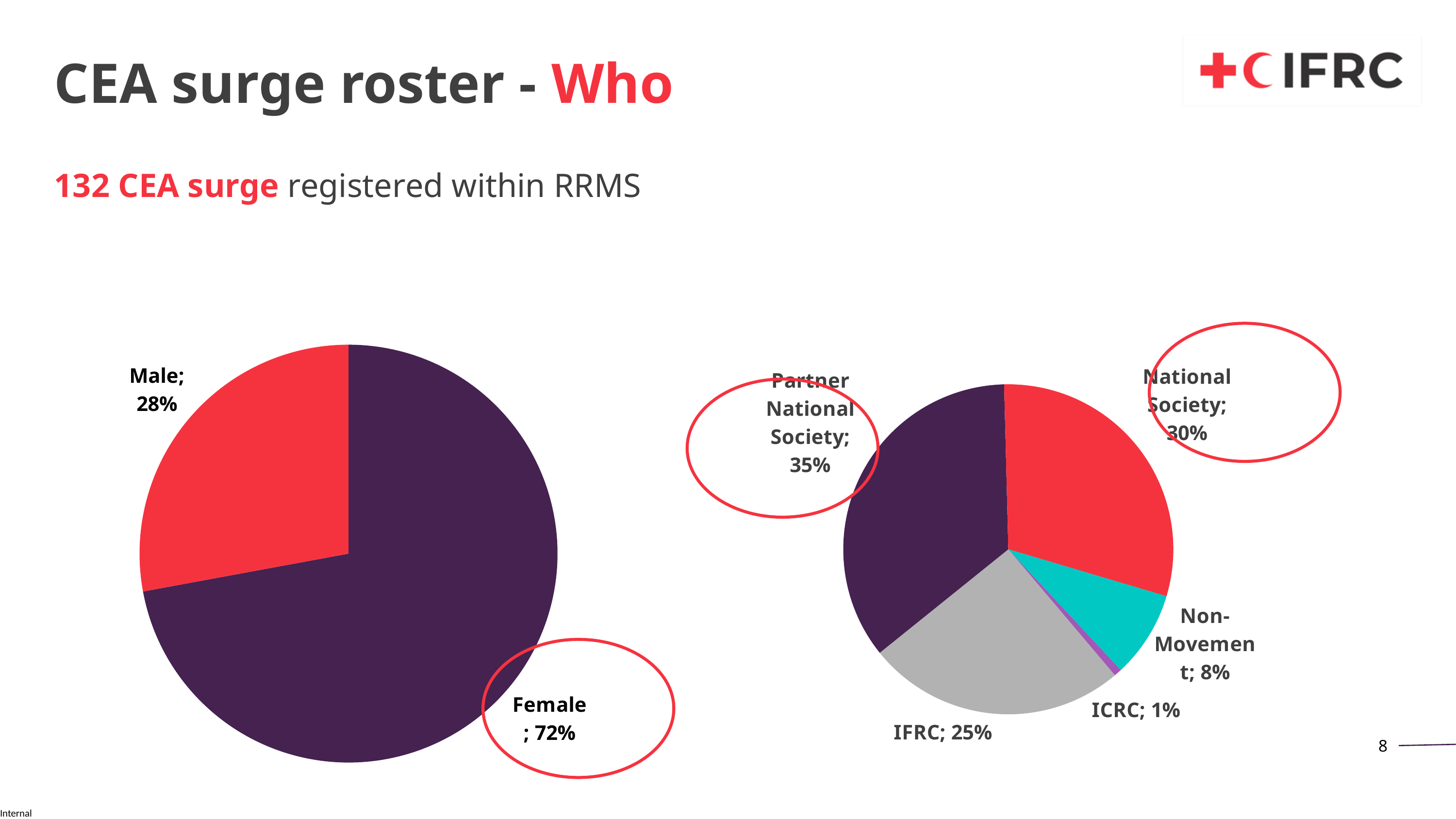
In the right pie chart, what is the difference between the National Society and IFRC shares? 5% In the right pie chart, which category has the smallest share? ICRC In the left pie chart, what is the difference between the Female and Male shares? 44% In the left pie chart, which slice is larger, Male or Female? Female What kind of chart is the chart on the left of the slide? Pie chart In the left pie chart, what share is labelled Female? 72% In the left pie chart, what share is labelled Male? 28% In the right pie chart, what share is labelled Non-Movement? 8% In the right pie chart, what share is labelled Partner National Society? 35% In the right pie chart, what share is labelled IFRC? 25% In the right pie chart, which category has the largest share? Partner National Society How many slices does the right pie chart have? 5